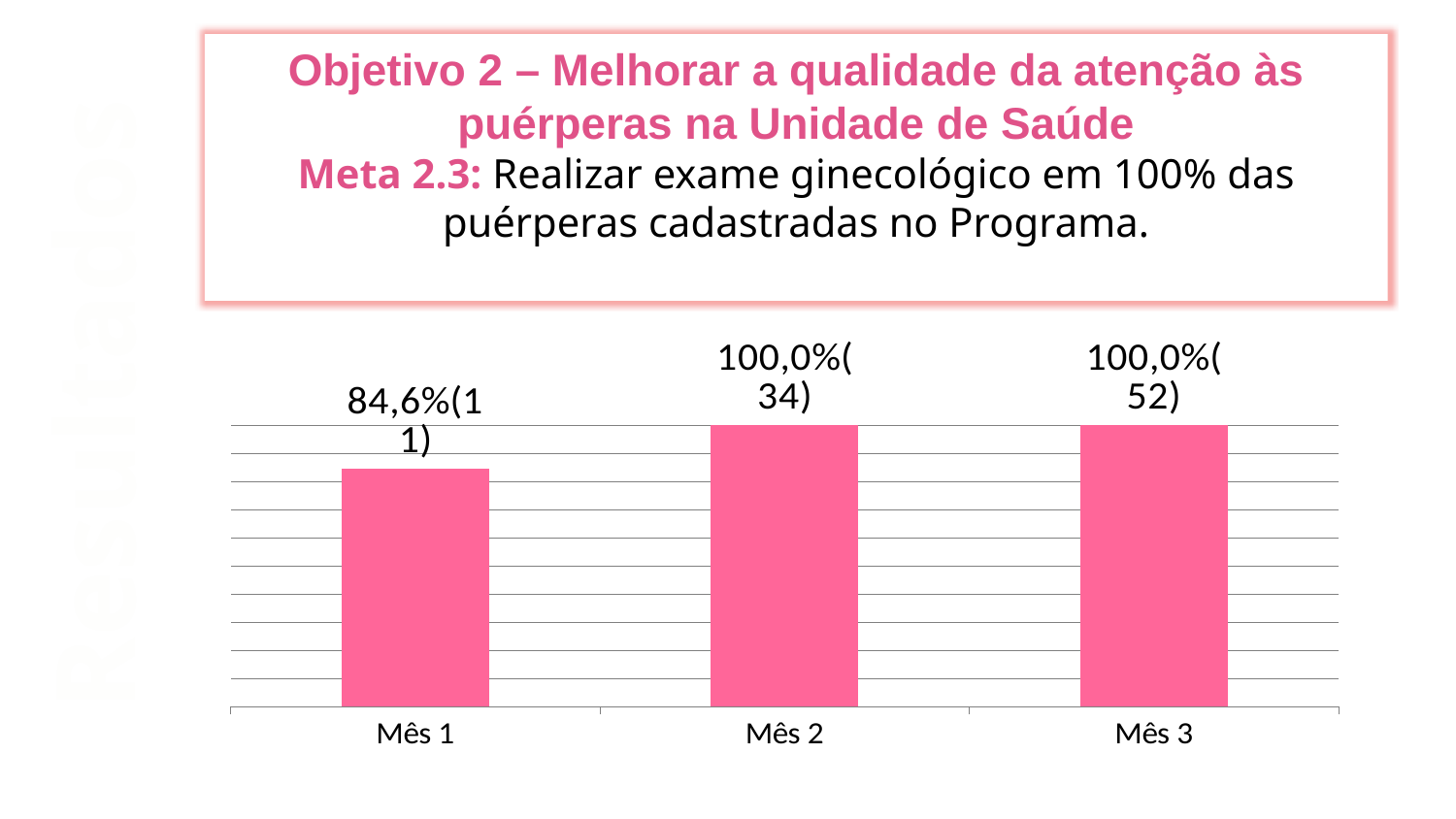
Which is larger, the percentage for Mês 1 or for Mês 2? Mês 2 Does the percentage rise or fall from Mês 1 to Mês 2? Rise What value is shown for Mês 1? 84,6% (11) What is the difference between the numbers in parentheses for Mês 3 and Mês 2? 18 What kind of chart is shown on the slide? Bar chart How many months are shown on the x axis? 3 What is the difference in percentage points between Mês 2 and Mês 1? 15,4 What value is shown for Mês 2? 100,0% (34) What colour are the bars in the chart? Pink What value is shown for Mês 3? 100,0% (52) What is the number in parentheses for Mês 3? 52 Which month has the lowest percentage? Mês 1